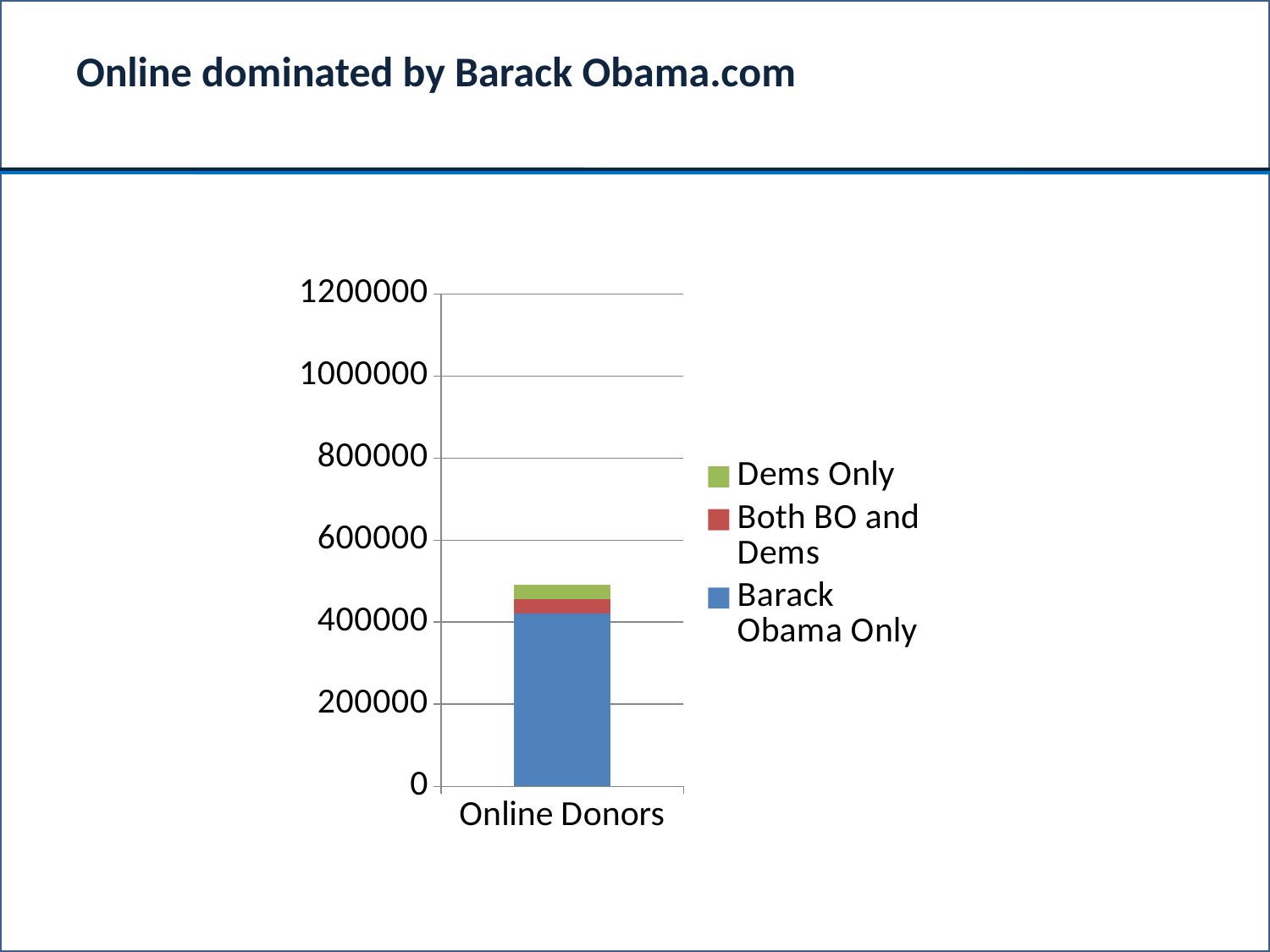
What kind of chart is shown on the slide? Stacked bar chart Which is larger for Online Donors: the 'Barack Obama Only' segment or the 'Dems Only' segment? Barack Obama Only How many series does the chart's legend list? 3 What is the highest value shown on the chart's vertical axis? 1200000 Is the total height of the Online Donors stacked bar greater or less than 400000? greater Is the total height of the Online Donors stacked bar greater or less than 600000? less Which series makes up the largest part of the Online Donors bar? Barack Obama Only Is the value of the 'Dems Only' segment for Online Donors greater or less than 200000? less Which colour represents the 'Barack Obama Only' series in the chart? Blue How many categories are shown on the x axis of the chart? 1 What is the label of the single category on the x axis? Online Donors